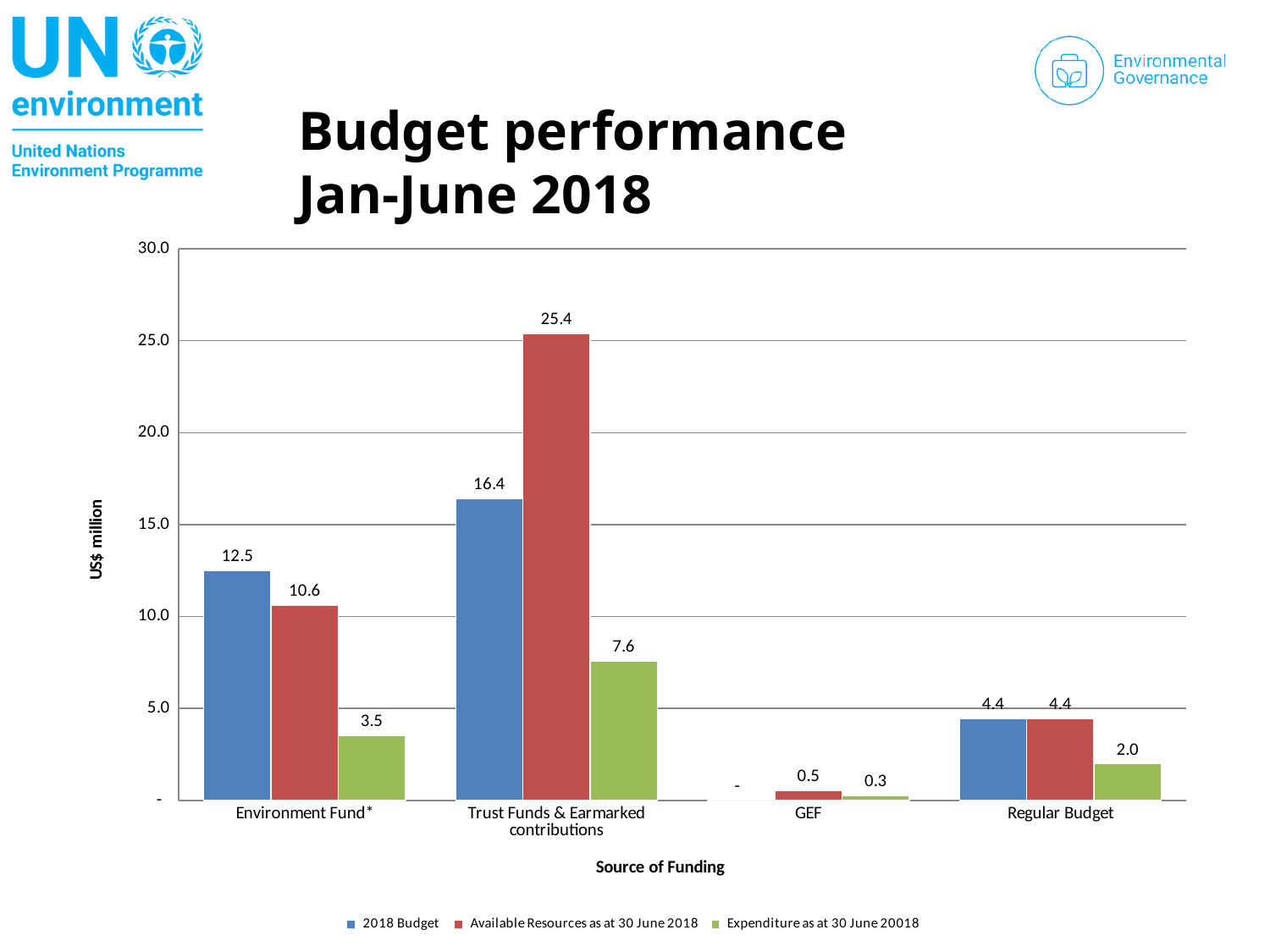
How many sources of funding are shown on the x axis? 4 How many series does the legend list? 3 What is the Available Resources as at 30 June 2018 value for Environment Fund*? 10.6 What kind of chart is shown on the slide? Bar chart Which is larger for Environment Fund*: the 2018 Budget or the Available Resources as at 30 June 2018? 2018 Budget What is the Expenditure as at 30 June 2018 value for Regular Budget? 2.0 What is the 2018 Budget value for Trust Funds & Earmarked contributions? 16.4 Which source of funding has the highest Available Resources as at 30 June 2018? Trust Funds & Earmarked contributions Is the Expenditure as at 30 June 2018 for Trust Funds & Earmarked contributions greater or less than 5.0? greater What is the difference between the Available Resources and the 2018 Budget for Trust Funds & Earmarked contributions? 9.0 Which source of funding has the lowest Expenditure as at 30 June 2018? GEF What is the label of the y axis? US$ million